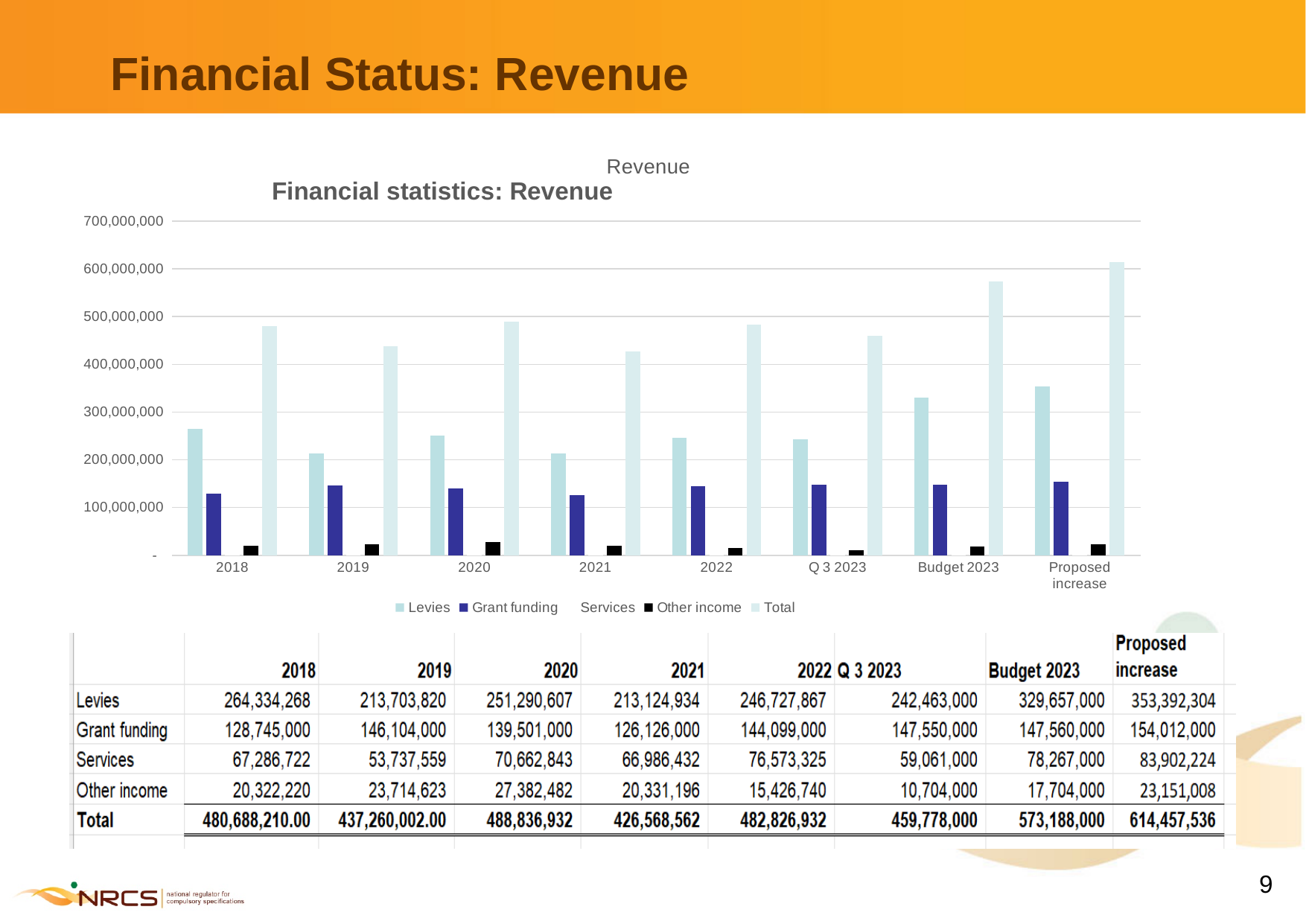
What is the value of Levies for 2018? 264,334,268 How many categories are shown along the x axis of the chart? 8 Which is larger, Grant funding in 2019 or Grant funding in 2021? 2019 Which category has the highest Total? Proposed increase Do the Total values rise or fall from Q 3 2023 to Proposed increase? rise What is the difference between the Total for Budget 2023 and the Total for Q 3 2023? 113,410,000 How many series does the chart legend list? 5 Is the Total for 2018 greater or less than 400,000,000? greater Which category has the lowest Other income? Q 3 2023 What is the value of Grant funding for 2020? 139,501,000 What type of chart is shown on the slide? bar chart What is the Total for Proposed increase? 614,457,536